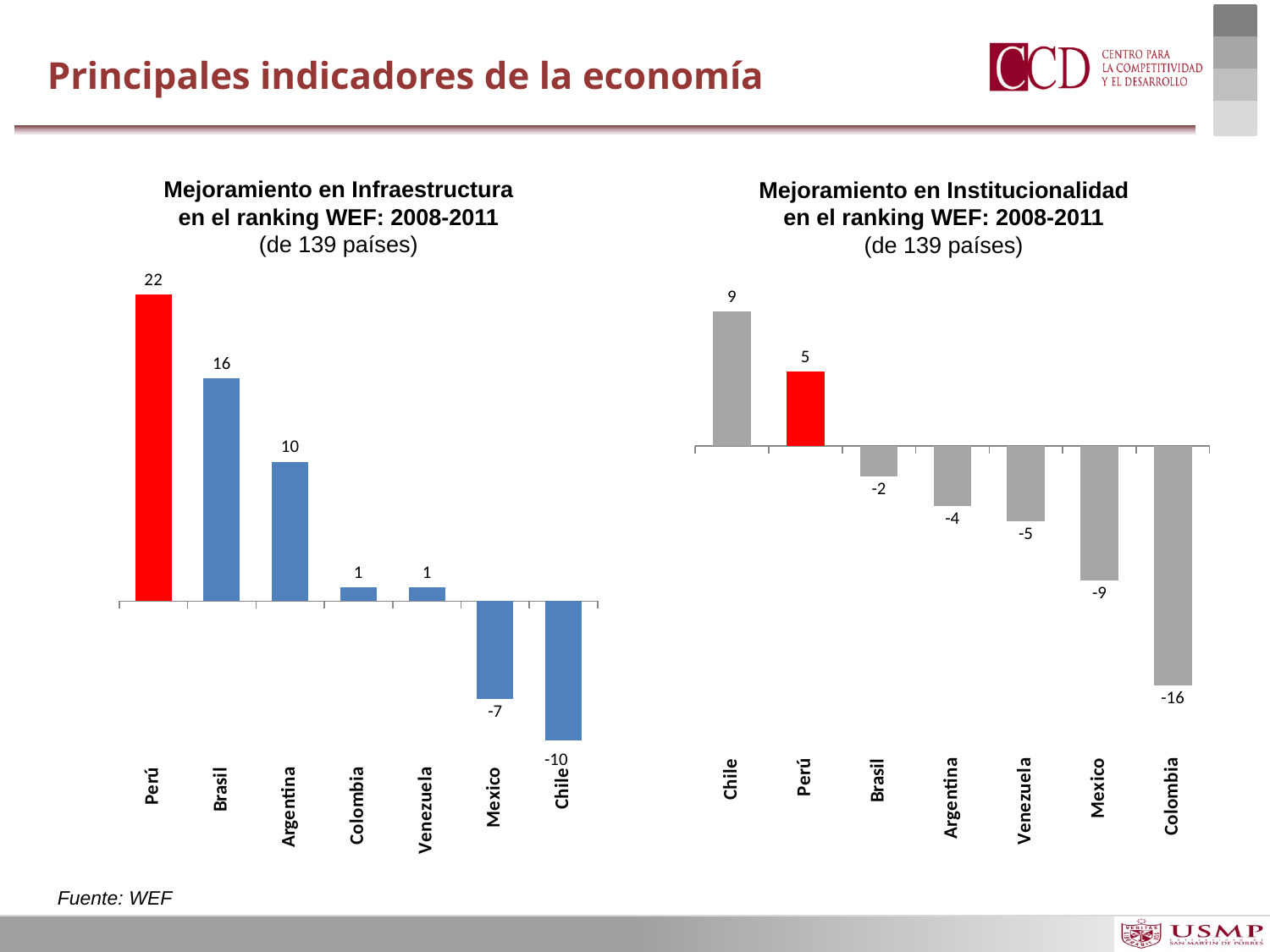
In the 'Mejoramiento en Infraestructura' chart, which country has the lowest value? Chile In the 'Mejoramiento en Institucionalidad' chart, which country's bar is coloured red? Perú In the 'Mejoramiento en Institucionalidad' chart, what is the value for Colombia? -16 In the 'Mejoramiento en Institucionalidad' chart, what is the difference between the values for Chile and Perú? 4 In the 'Mejoramiento en Infraestructura' chart, what is the value for Mexico? -7 In the 'Mejoramiento en Institucionalidad' chart, what is the value for Chile? 9 In the 'Mejoramiento en Institucionalidad' chart, which country has the highest value? Chile In the 'Mejoramiento en Infraestructura' chart, what is the value for Perú? 22 In the 'Mejoramiento en Institucionalidad' chart, which is larger, the value for Argentina or the value for Venezuela? Argentina In the 'Mejoramiento en Infraestructura' chart, what is the difference between the values for Perú and Brasil? 6 In the 'Mejoramiento en Infraestructura' chart, how many countries are shown? 7 What type of chart is the 'Mejoramiento en Infraestructura' chart? Bar chart